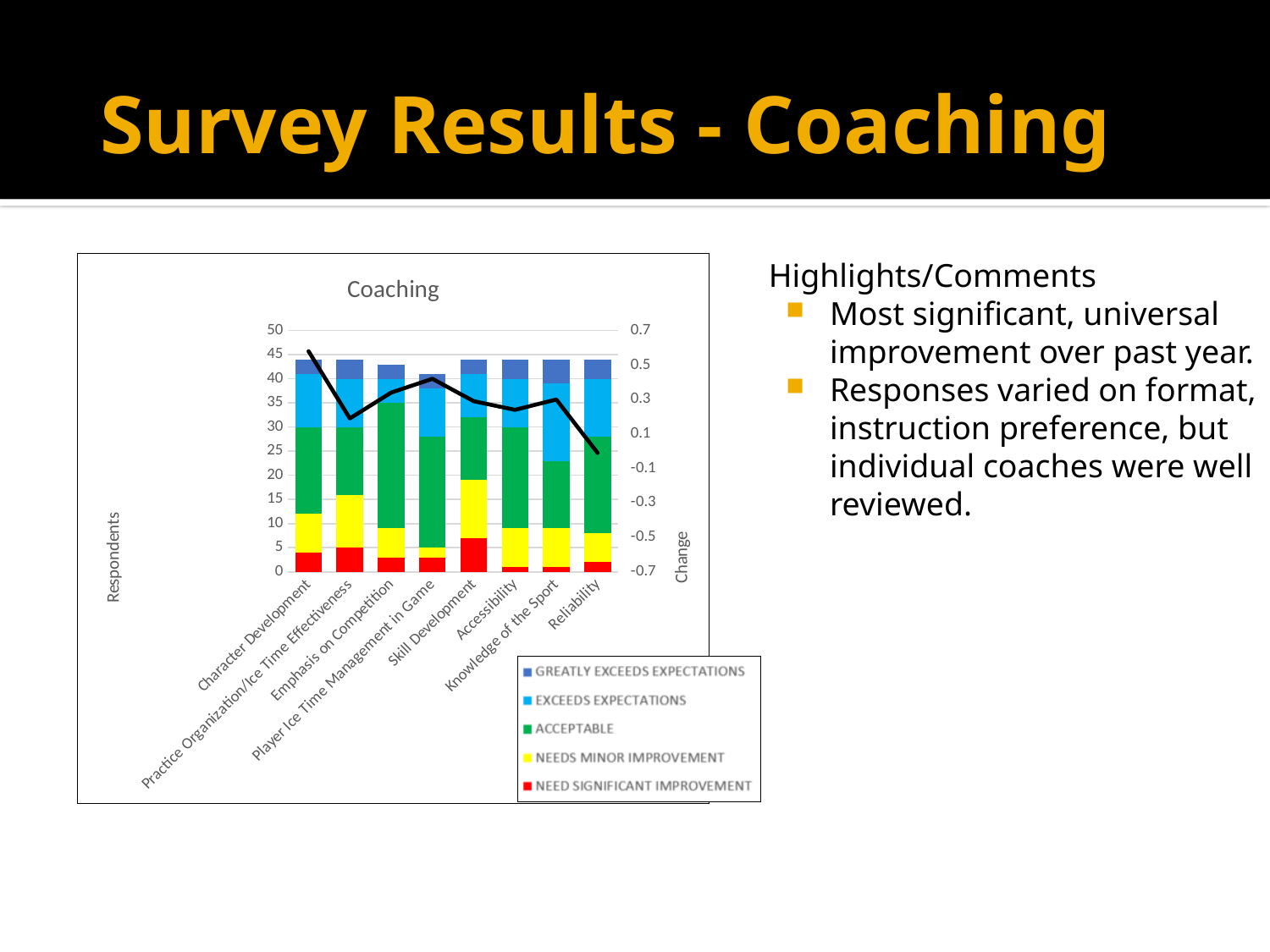
Is the NEED SIGNIFICANT IMPROVEMENT value for Skill Development greater or less than 5 respondents? greater How many series does the legend list? 5 How many categories are shown on the x axis of the chart? 8 Is the NEED SIGNIFICANT IMPROVEMENT value for Accessibility greater or less than 5 respondents? less Is the Change line value for Reliability greater or less than 0.1? less What kind of chart is shown on the slide? Stacked bar chart with a line What is the title of the chart? Coaching Which category has the largest NEED SIGNIFICANT IMPROVEMENT segment? Skill Development What is the label of the left vertical axis? Respondents Is the Change line value higher for Character Development or for Reliability? Character Development